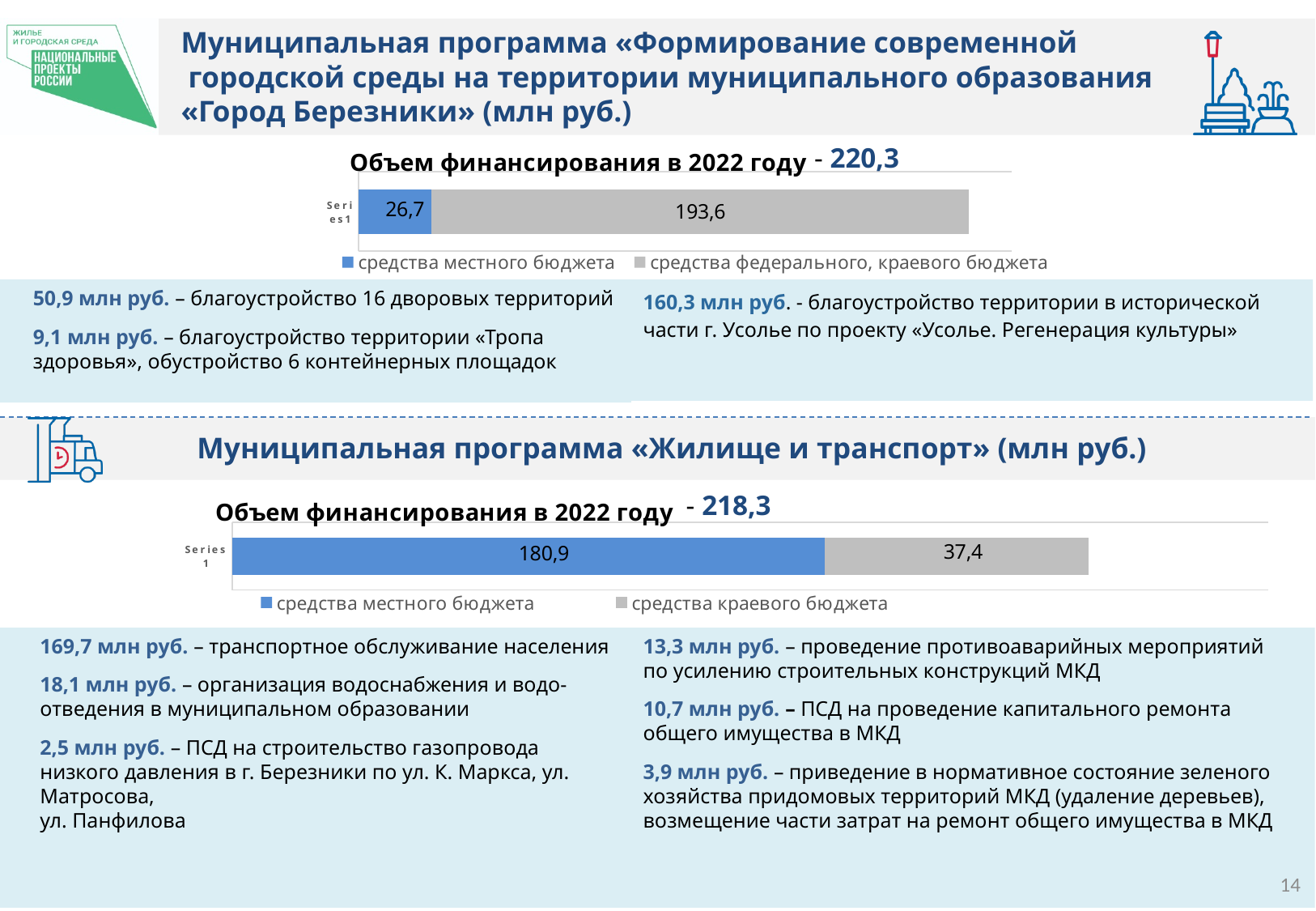
In the bottom chart, which series has the larger value: средства местного бюджета or средства краевого бюджета? средства местного бюджета In the bottom chart (Жилище и транспорт), what is the value for средства краевого бюджета? 37,4 In the top chart (Формирование современной городской среды), what is the value for средства федерального, краевого бюджета? 193,6 In the top chart, which series has the larger value: средства местного бюджета or средства федерального, краевого бюджета? средства федерального, краевого бюджета In the top chart, what is the total of the stacked bar? 220,3 In the top chart (Формирование современной городской среды), what is the value for средства местного бюджета? 26,7 What kind of chart is the bottom chart (Жилище и транспорт)? stacked bar chart In the top chart, what is the difference between средства федерального, краевого бюджета and средства местного бюджета? 166,9 How many series does the legend of the top chart list? 2 In the bottom chart, what is the total of the stacked bar? 218,3 In the bottom chart (Жилище и транспорт), what is the value for средства местного бюджета? 180,9 In the bottom chart, what is the difference between средства местного бюджета and средства краевого бюджета? 143,5